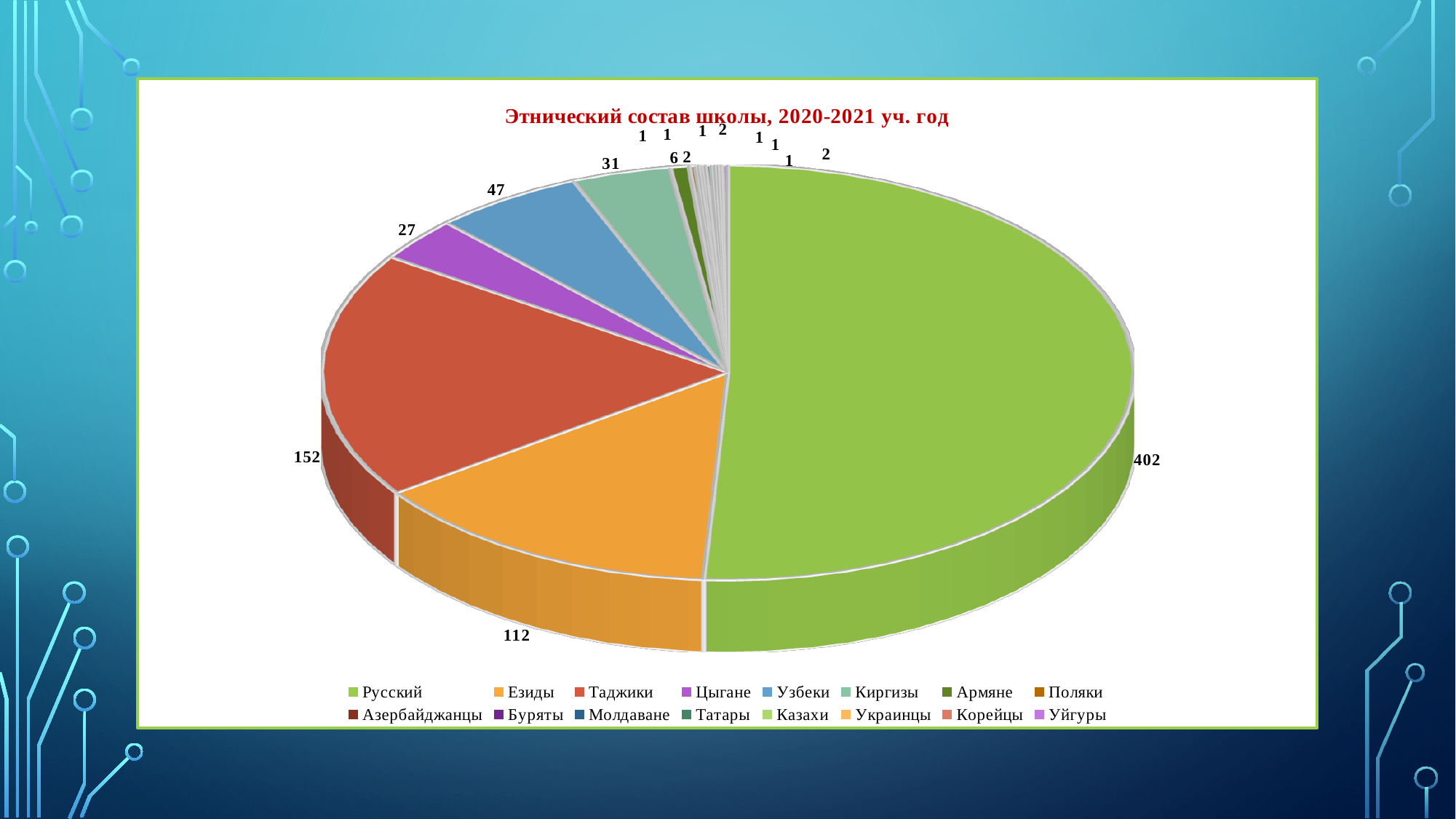
How many categories does the legend list? 16 What is the value for Узбеки? 47 What is the value for Киргизы? 31 Which category has the largest slice? Русский What is the value for Цыгане? 27 What is the difference between the values for Таджики and Езиды? 40 What is the value for Русский? 402 Which is larger, Таджики or Езиды? Таджики What is the value for Таджики? 152 What is the title of the chart? Этнический состав школы, 2020-2021 уч. год What type of chart is shown on the slide? pie chart What is the value for Езиды? 112